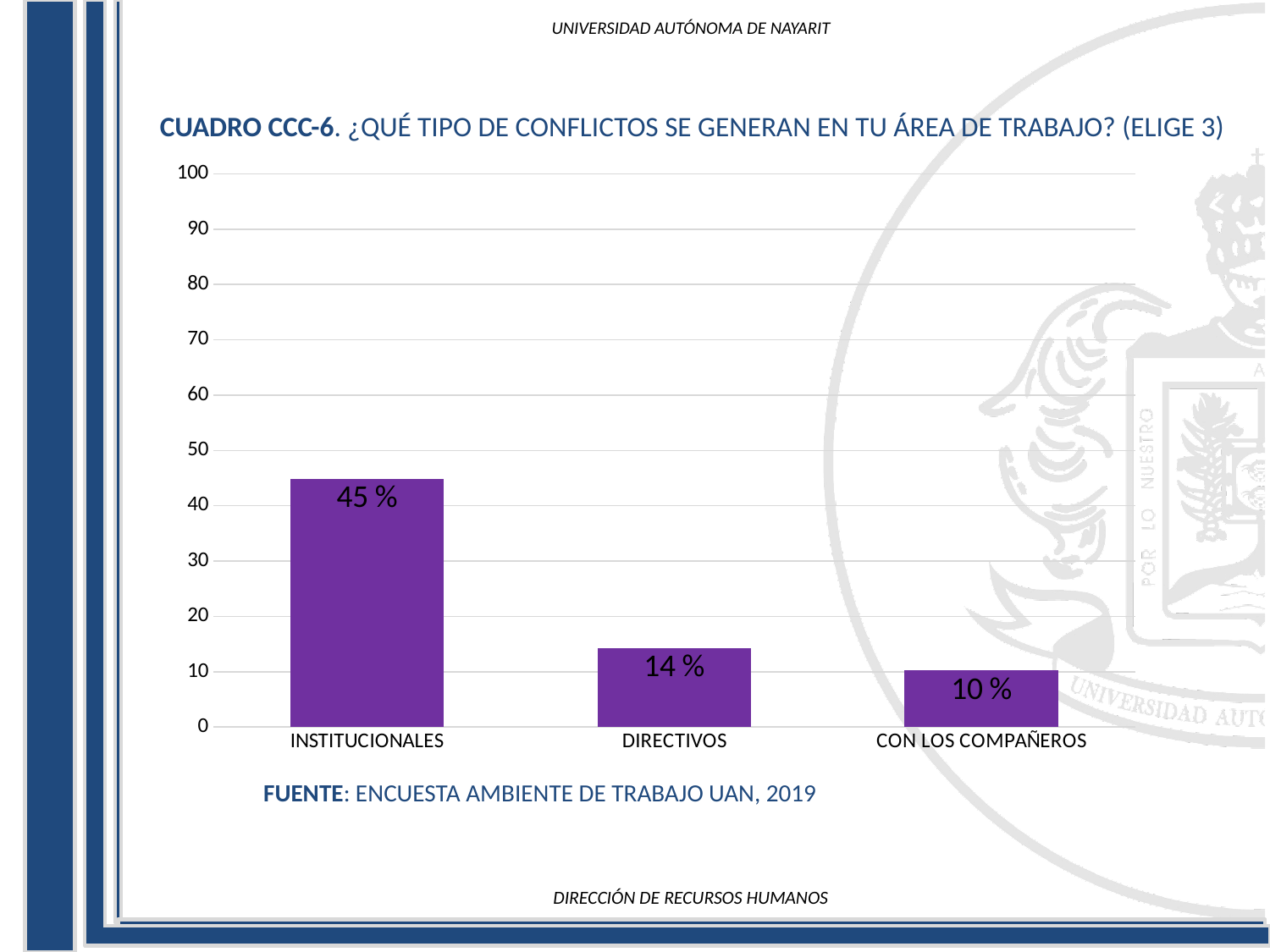
How many categories are shown on the x axis? 3 What source is cited below the chart? ENCUESTA AMBIENTE DE TRABAJO UAN, 2019 What is the value for INSTITUCIONALES? 45 % What is the difference between the values for DIRECTIVOS and CON LOS COMPAÑEROS? 4 % Which category has the lowest value? CON LOS COMPAÑEROS What is the value for DIRECTIVOS? 14 % Which category has the highest value? INSTITUCIONALES What is the difference between the values for INSTITUCIONALES and DIRECTIVOS? 31 % What kind of chart is shown on the slide? bar chart What is the value for CON LOS COMPAÑEROS? 10 % Which is larger, the value for DIRECTIVOS or the value for CON LOS COMPAÑEROS? DIRECTIVOS Is the value for INSTITUCIONALES greater or less than 50? less